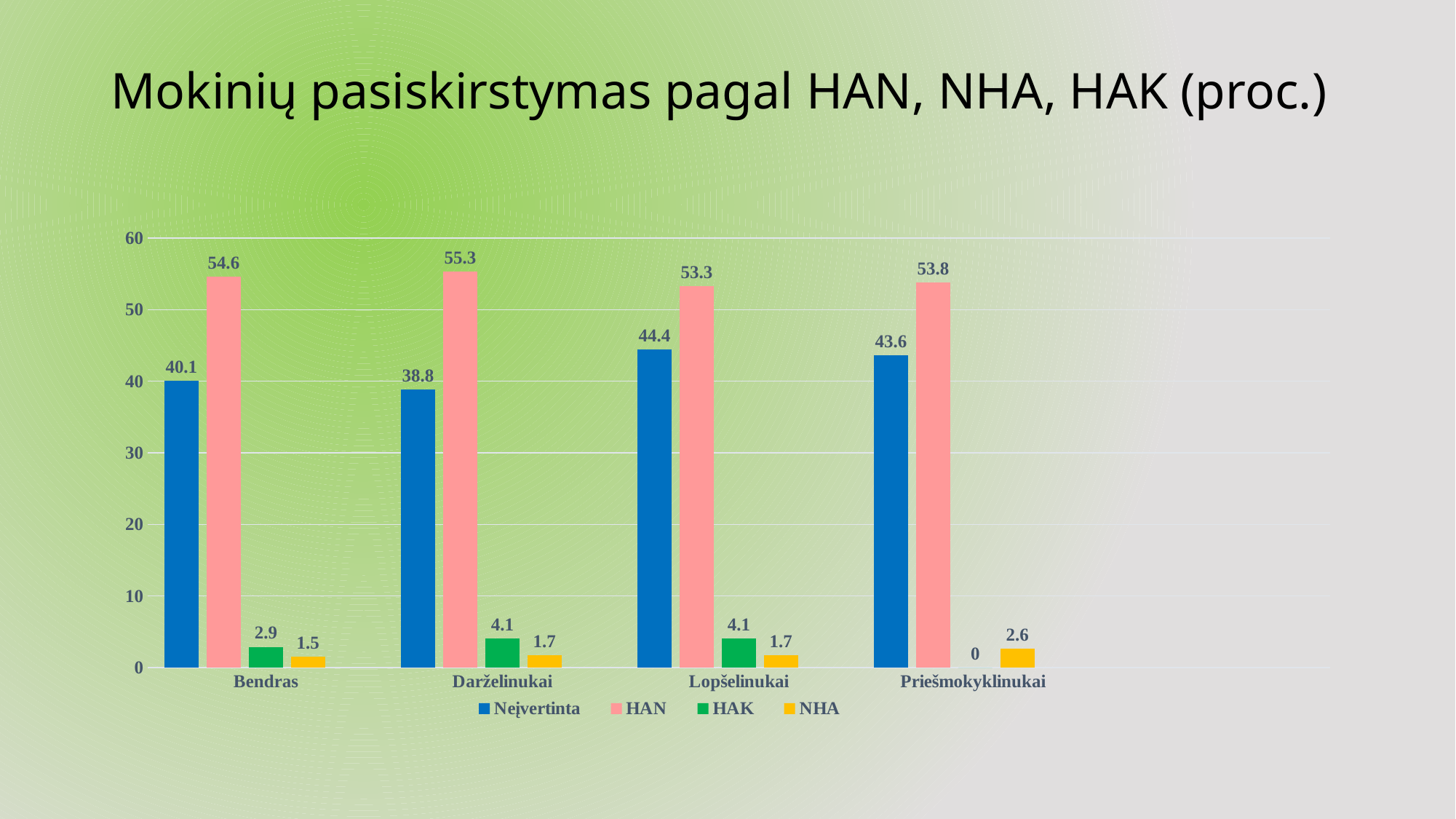
Which is larger for Bendras: the HAK value or the NHA value? HAK What is the HAN value for Darželinukai? 55.3 What is the Neįvertinta value for Bendras? 40.1 What is the HAK value for Priešmokyklinukai? 0 How many categories are shown on the x axis? 4 What is the difference between the HAN and Neįvertinta values for Lopšelinukai? 8.9 What kind of chart is shown on the slide? Bar chart Which category has the lowest Neįvertinta value? Darželinukai Is the Neįvertinta value for Priešmokyklinukai greater or less than 40? greater Which category has the highest HAN value? Darželinukai What is the NHA value for Priešmokyklinukai? 2.6 How many series does the legend list? 4